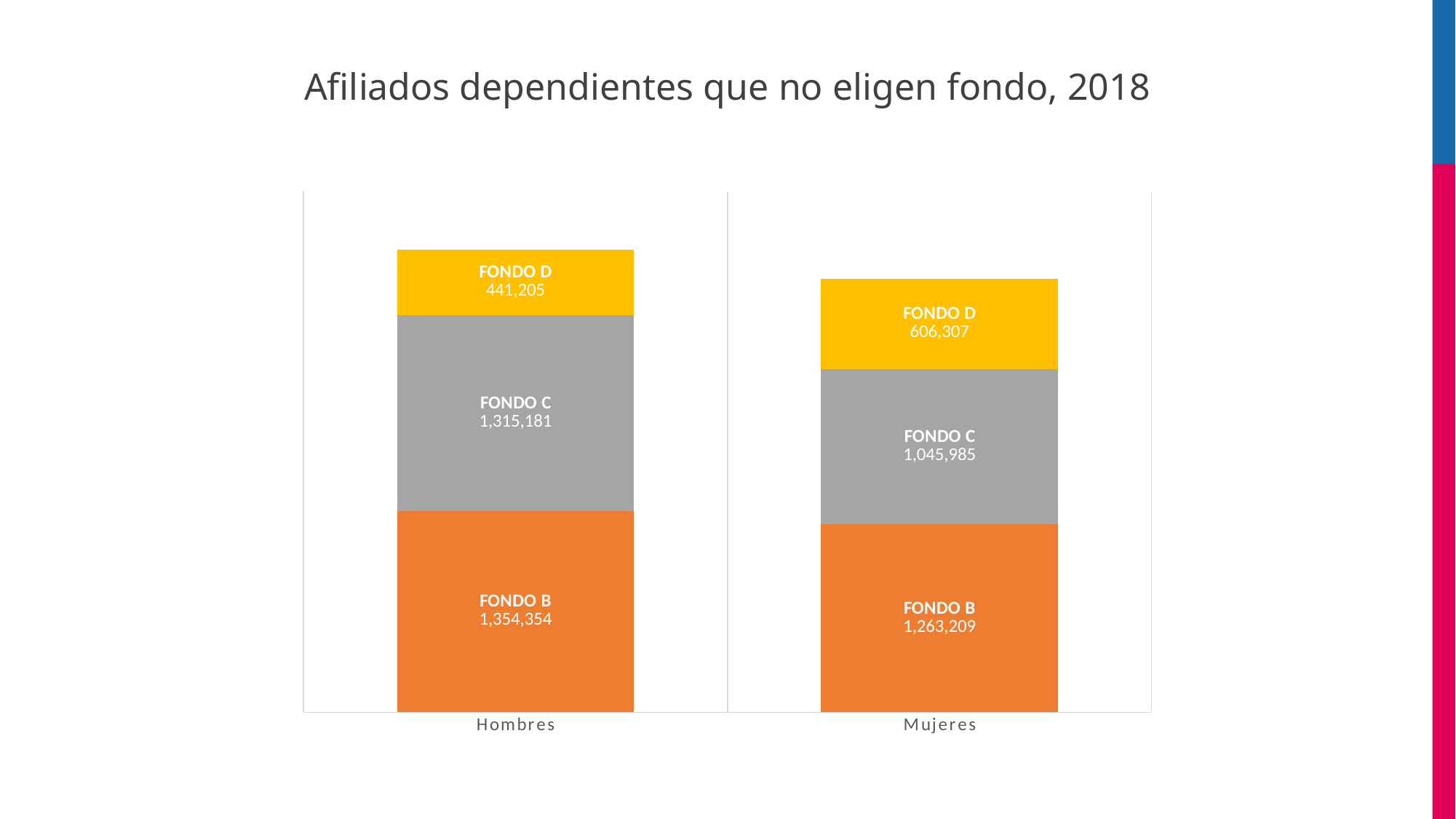
What is the value for FONDO C in the Mujeres bar? 1,045,985 How many categories are shown on the x axis? 2 What is the difference between the FONDO B values for Hombres and Mujeres? 91,145 What is the value for FONDO D in the Mujeres bar? 606,307 What is the total of the Hombres stacked bar? 3,110,740 Which segment is the largest in the Mujeres bar? FONDO B What is the value for FONDO D in the Hombres bar? 441,205 Which segment is the smallest in the Hombres bar? FONDO D Which category has the taller stacked bar, Hombres or Mujeres? Hombres What is the difference between the FONDO D values for Mujeres and Hombres? 165,102 What is the value for FONDO B in the Hombres bar? 1,354,354 What is the total of the Mujeres stacked bar? 2,915,501